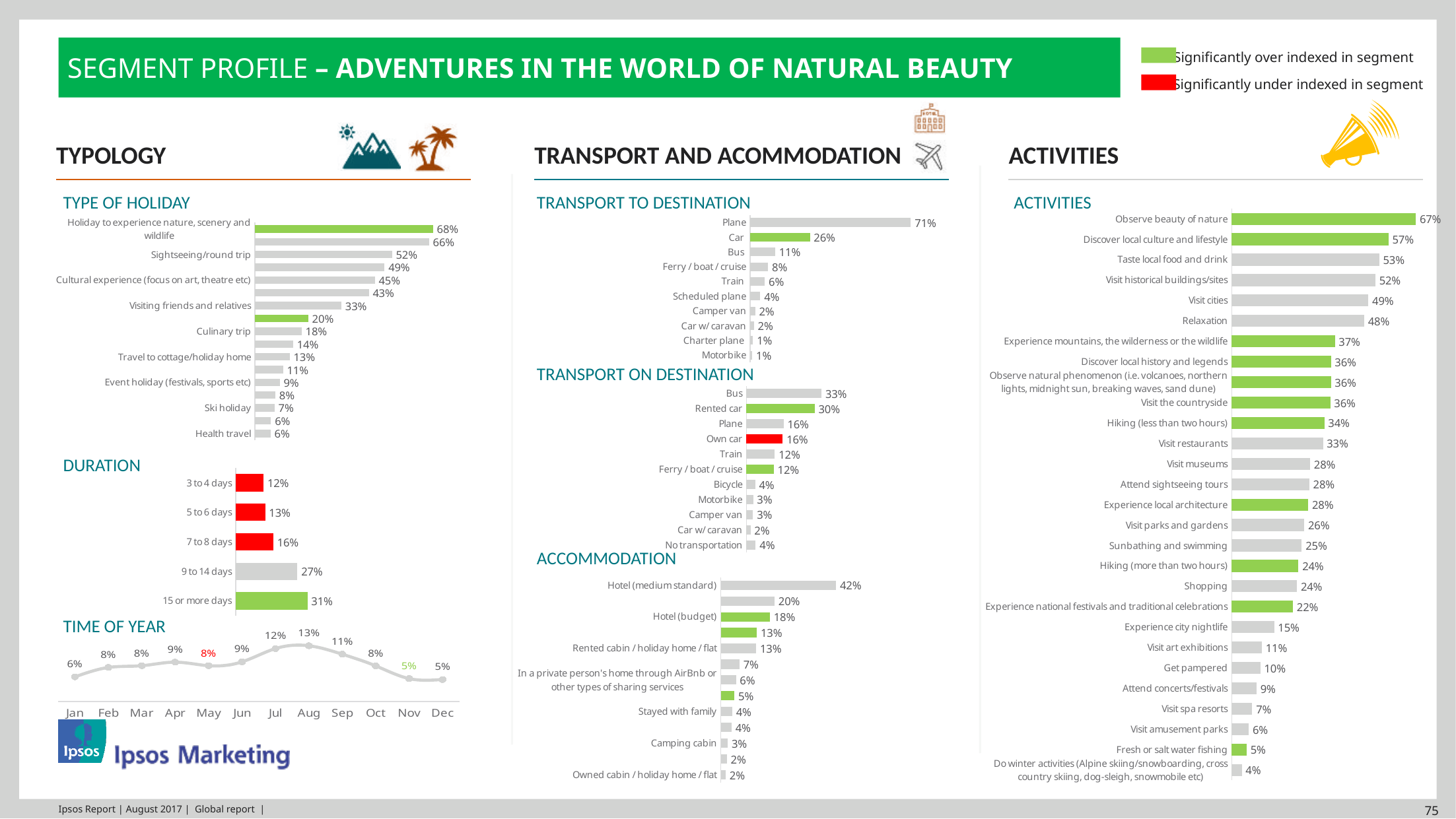
In the Duration chart, which category has the highest value? 15 or more days How many months are plotted in the Time of Year chart? 12 In the Time of Year chart, which month has the highest value? Aug In the Time of Year chart, what is the value for Jul? 12% In the Transport to Destination chart, what is the value for Plane? 71% In the Accommodation chart, what is the value for Hotel (medium standard)? 42% In the Transport on Destination chart, which is larger: Bus or Rented car? Bus In the Duration chart, how many categories are shown? 5 In the Activities chart, what is the value for Visit the countryside? 36% What kind of chart is the Time of Year chart? Line chart In the Activities chart, which activity has the lowest value? Do winter activities (Alpine skiing/snowboarding, cross country skiing, dog-sleigh, snowmobile etc) In the Duration chart, what is the difference between the values for 9 to 14 days and 3 to 4 days? 15%